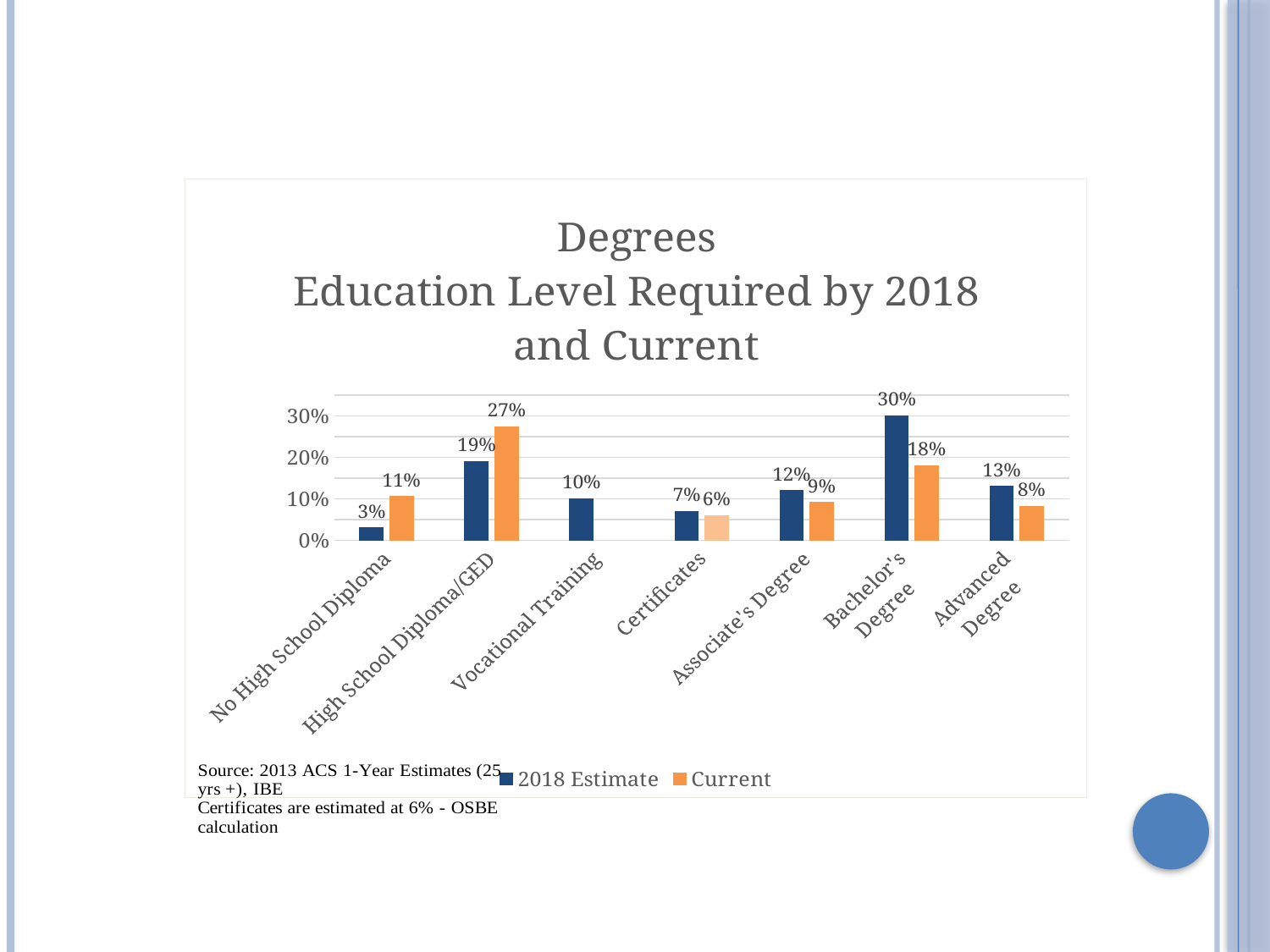
Is the Current value for High School Diploma/GED greater or less than 20%? greater How many education level categories are shown on the x axis? 7 What is the 2018 Estimate value for No High School Diploma? 3% Which category has the lowest 2018 Estimate value? No High School Diploma Which is larger for Associate's Degree, the 2018 Estimate or the Current value? 2018 Estimate What type of chart is shown on the slide? bar chart What is the difference between the 2018 Estimate and Current values for Bachelor's Degree? 12% Which category has the highest 2018 Estimate value? Bachelor's Degree Which series is shown in orange in the legend? Current What is the 2018 Estimate value for Bachelor's Degree? 30% What is the Current value for High School Diploma/GED? 27% How many series does the legend list? 2